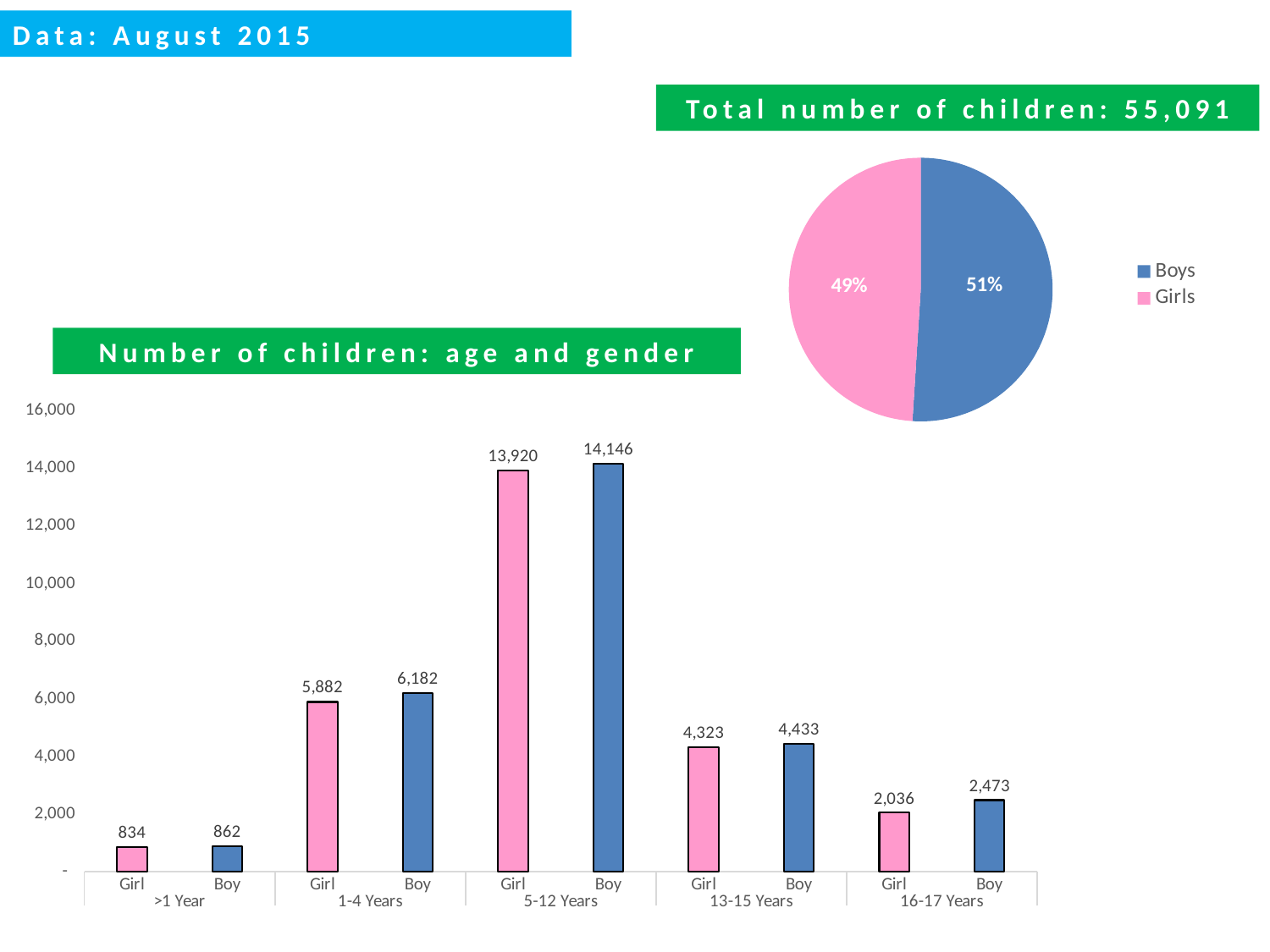
In the bar chart 'Number of children: age and gender', what is the value for Boy in the 16-17 Years group? 2,473 In the pie chart, what colour is the Girls slice? Pink In the bar chart 'Number of children: age and gender', which bar has the lowest value? Girl, >1 Year In the bar chart 'Number of children: age and gender', how many age groups are shown on the x axis? 5 In the bar chart 'Number of children: age and gender', how many bars are plotted? 10 In the bar chart 'Number of children: age and gender', which bar has the highest value? Boy, 5-12 Years In the pie chart, how many series does the legend list? 2 In the pie chart, what share of children are Boys? 51% In the bar chart 'Number of children: age and gender', what is the value for Girl in the 5-12 Years group? 13,920 In the bar chart 'Number of children: age and gender', which is larger in the 13-15 Years group, Girl or Boy? Boy What kind of chart is the chart titled 'Number of children: age and gender'? Bar chart In the bar chart 'Number of children: age and gender', what is the difference between Boy and Girl in the 1-4 Years group? 300